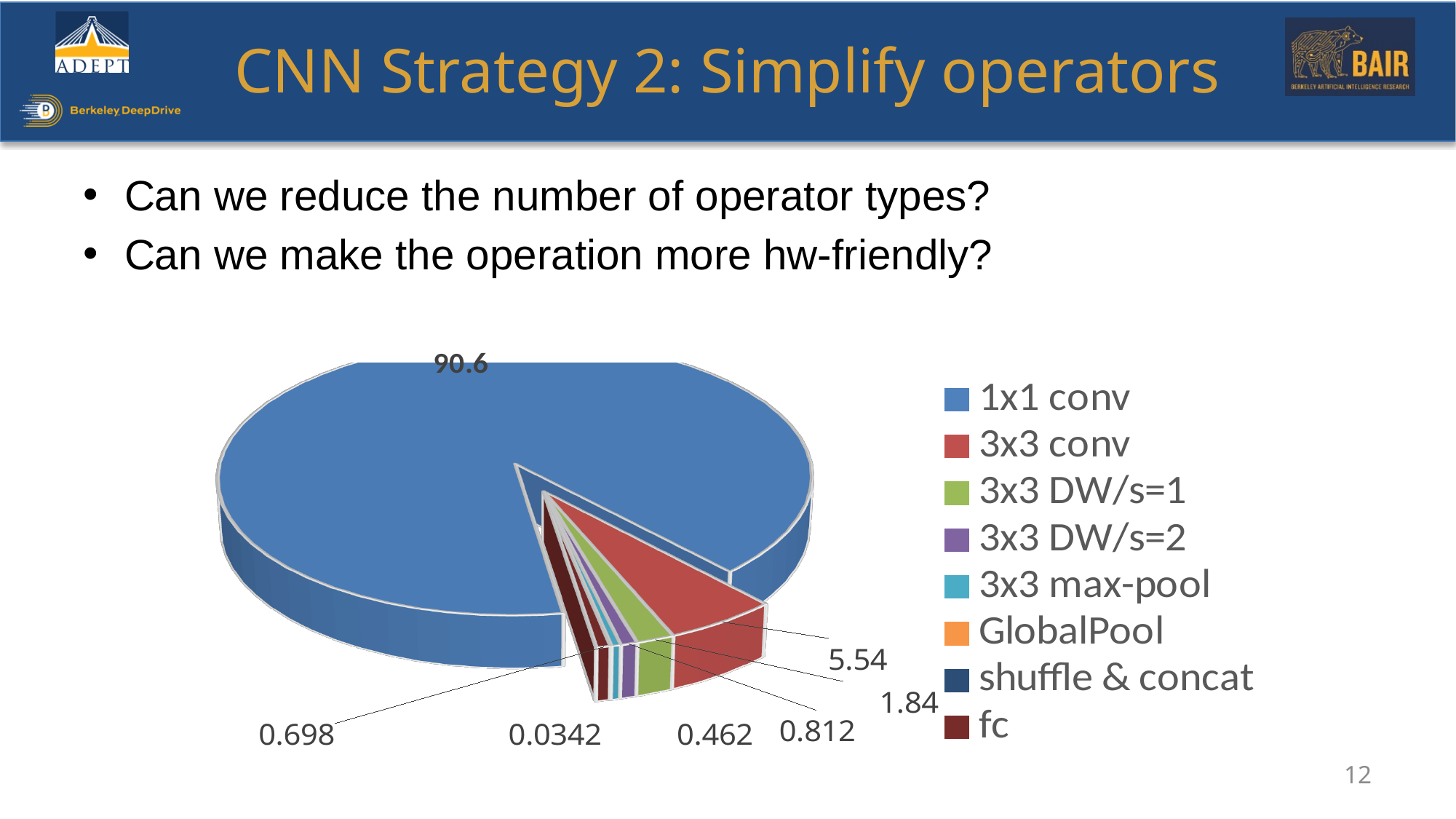
Is the value for 1x1 conv greater or less than 50? greater What is the value shown for the 3x3 conv slice? 5.54 Which is larger, the 1x1 conv slice or the 3x3 conv slice? 1x1 conv Which category has the largest slice of the pie? 1x1 conv How many categories does the legend list? 8 Which legend entry is listed last? fc What is the difference between the 1x1 conv value and the 3x3 conv value? 85.06 Is the value for 3x3 conv greater or less than 10? less What type of chart is shown on the slide? pie chart What is the value shown for the 1x1 conv slice? 90.6 What is the smallest data label shown on the pie chart? 0.0342 What colour is used for the 1x1 conv slice? blue